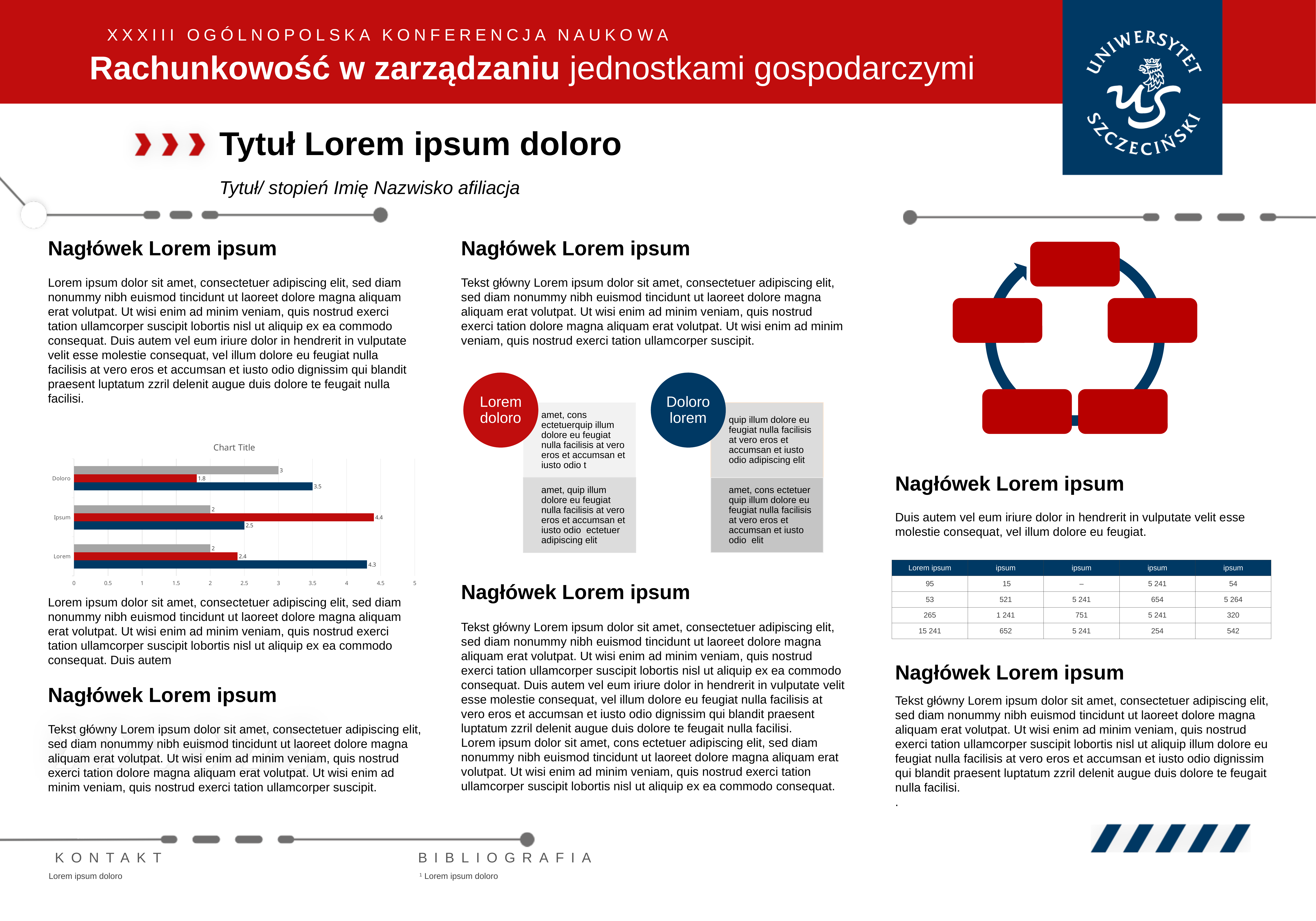
Which category has the lowest red bar in the bar chart? Doloro What is the value of the red bar for Doloro in the bar chart? 1.8 What kind of chart is shown on the slide? bar chart What is the value of the red bar for Ipsum in the bar chart? 4.4 What is the value of the dark blue bar for Lorem in the bar chart? 4.3 What is the value of the gray bar for Doloro in the bar chart? 3 For Ipsum, which is larger: the red bar or the dark blue bar? the red bar What is the difference between the gray bar and the red bar for Doloro? 1.2 How many categories are shown on the vertical axis of the bar chart? 3 What is the difference between the dark blue bar for Lorem and the dark blue bar for Doloro? 0.8 What is the title of the bar chart? Chart Title Which category has the highest dark blue bar in the bar chart? Lorem